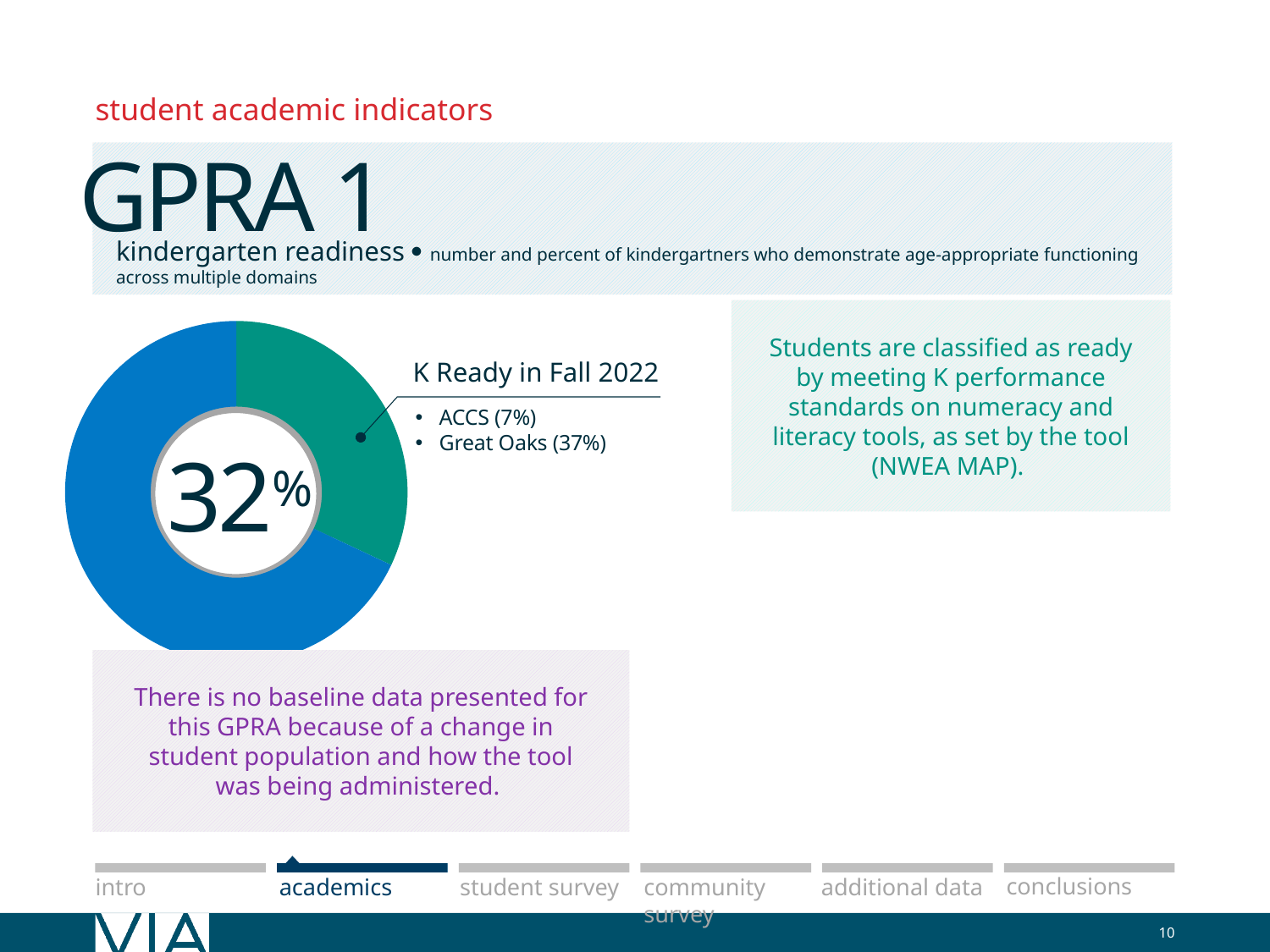
What kind of chart is shown on the slide? Pie (donut) chart What share of the donut chart is taken by the K Ready in Fall 2022 slice? 32% How many slices does the donut chart have? 2 Which of the two schools listed in the callout has the lowest K Ready percentage? ACCS What percentage is printed in the center of the donut chart? 32% Is the K Ready in Fall 2022 share greater or less than 50%? less What is the difference in percentage points between the Great Oaks and ACCS K Ready values in the callout? 30 percentage points What percentage of kindergartners were K Ready in Fall 2022 at Great Oaks, according to the callout? 37% What does the green slice of the donut chart represent, according to the callout label? K Ready in Fall 2022 What percentage of kindergartners were K Ready in Fall 2022 at ACCS, according to the callout? 7% What colour is the slice representing students who were K Ready in Fall 2022? Green Which school has the higher K Ready percentage in the callout, ACCS or Great Oaks? Great Oaks